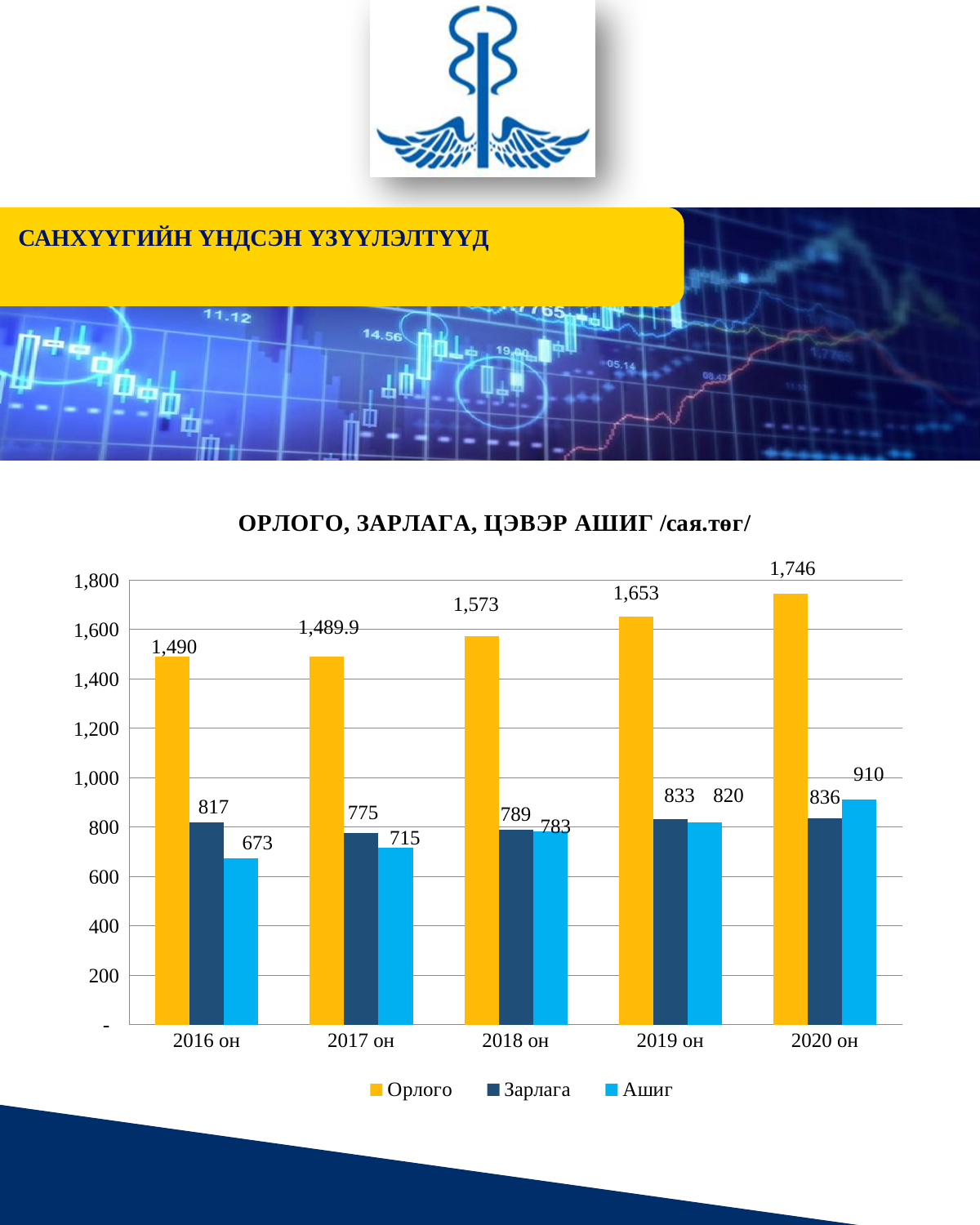
Does Ашиг rise or fall from 2016 он to 2020 он? Rise What is the value of Орлого for 2018 он? 1,573 How many years are shown on the x axis? 5 What is the difference between Орлого and Зарлага in 2019 он? 820 What is the value of Зарлага for 2020 он? 836 What is the value of Орлого for 2017 он? 1,489.9 What kind of chart is shown on the slide? Bar chart Which is larger in 2020 он, Зарлага or Ашиг? Ашиг How many series does the legend list? 3 In which year is Орлого highest? 2020 он What is the value of Ашиг for 2016 он? 673 In which year is Ашиг lowest? 2016 он